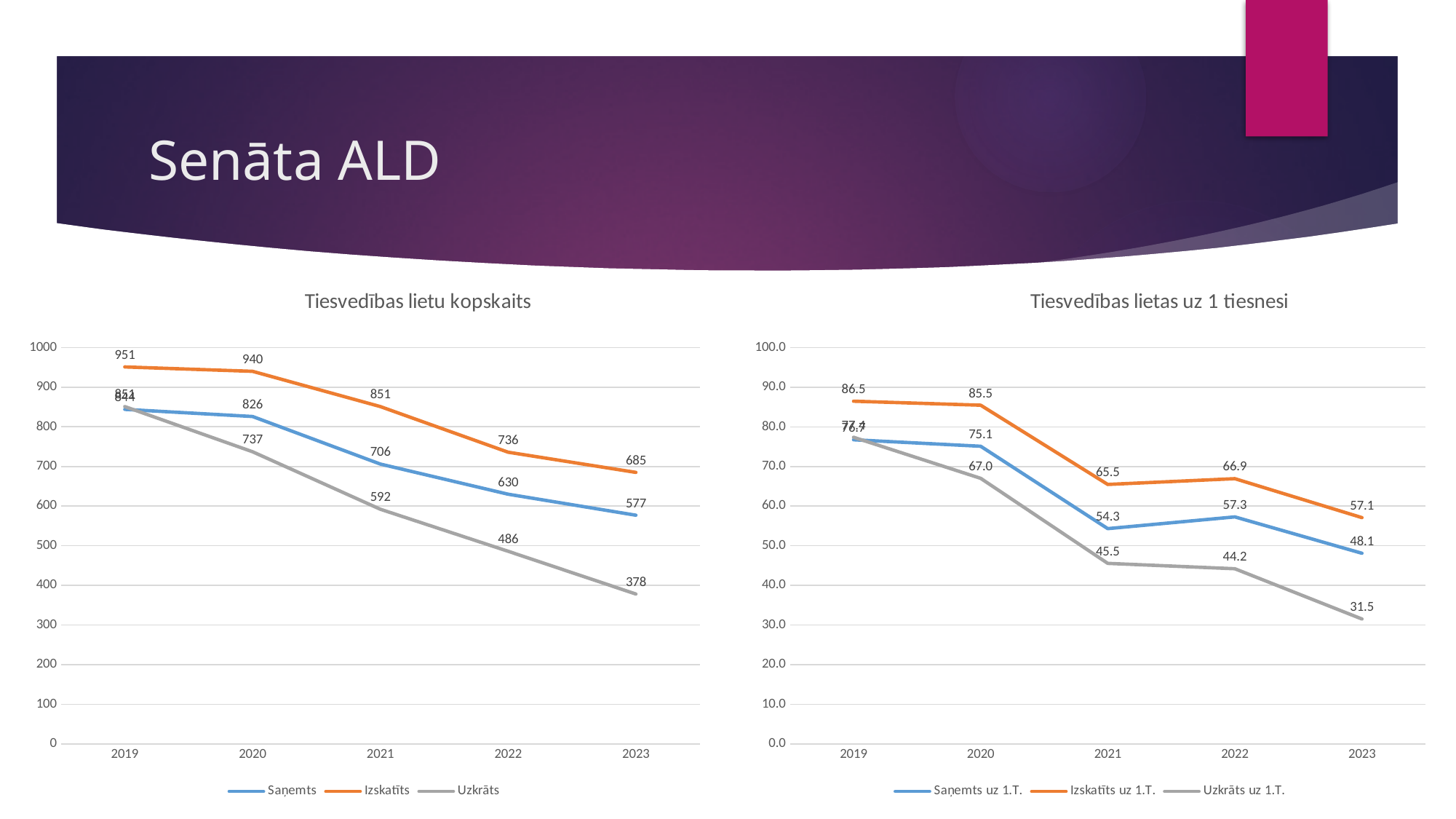
In the chart 'Tiesvedības lietu kopskaits', what is the difference between Izskatīts and Saņemts in 2022? 106 In the chart 'Tiesvedības lietu kopskaits', what is the value for Izskatīts in 2021? 851 In the chart 'Tiesvedības lietu kopskaits', in which year is Izskatīts highest? 2019 In the chart 'Tiesvedības lietas uz 1 tiesnesi', which is larger in 2023: Saņemts uz 1.T. or Izskatīts uz 1.T.? Izskatīts uz 1.T. In the chart 'Tiesvedības lietu kopskaits', what is the value for Uzkrāts in 2023? 378 In the chart 'Tiesvedības lietas uz 1 tiesnesi', what is the value for Uzkrāts uz 1.T. in 2021? 45.5 What kind of chart is 'Tiesvedības lietas uz 1 tiesnesi'? line chart In the chart 'Tiesvedības lietu kopskaits', does the Uzkrāts series rise or fall from 2019 to 2023? fall In the chart 'Tiesvedības lietu kopskaits', what is the value for Saņemts in 2020? 826 In the chart 'Tiesvedības lietas uz 1 tiesnesi', in which year is Uzkrāts uz 1.T. lowest? 2023 In the chart 'Tiesvedības lietas uz 1 tiesnesi', what is the value for Izskatīts uz 1.T. in 2022? 66.9 In the chart 'Tiesvedības lietu kopskaits', how many series does the legend list? 3